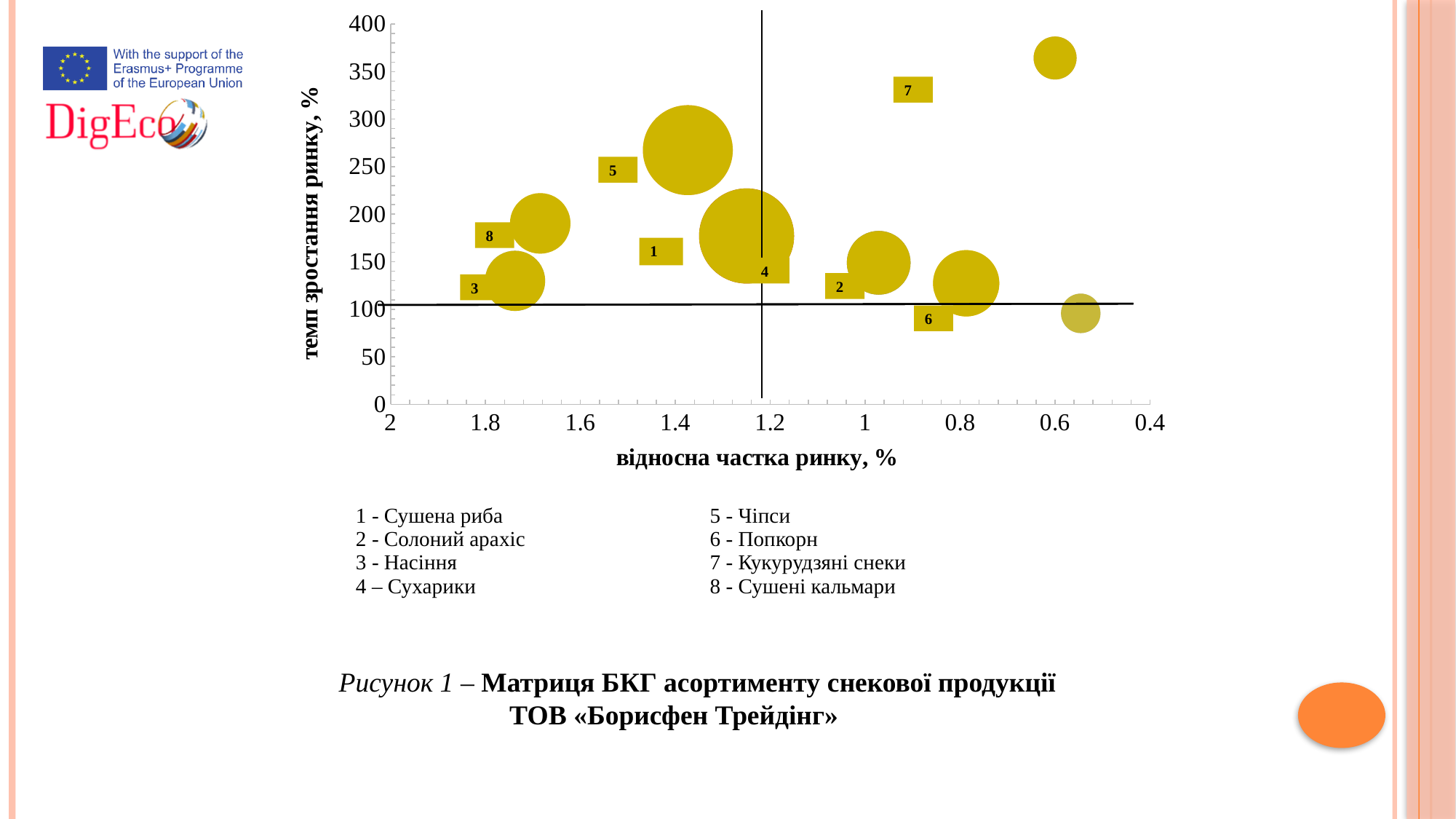
What is the title of the horizontal axis of the chart? відносна частка ринку, % Is the market growth rate for product 5 (Чіпси) greater or less than 200? greater What is the maximum value shown on the vertical axis of the chart? 400 Is the market growth rate for product 7 (Кукурудзяні снеки) greater or less than 300? greater Is the market growth rate for product 3 (Насіння) greater or less than 200? less Which has a higher market growth rate, product 5 (Чіпси) or product 8 (Сушені кальмари)? 5 - Чіпси Which numbered product has the highest market growth rate on the chart? 7 - Кукурудзяні снеки What kind of chart is shown on the slide? bubble chart How many products are listed in the legend below the chart? 8 Which product does the number 6 in the legend refer to? Попкорн What is the title of the vertical axis of the chart? темп зростання ринку, % Which has a higher market growth rate, product 7 (Кукурудзяні снеки) or product 3 (Насіння)? 7 - Кукурудзяні снеки